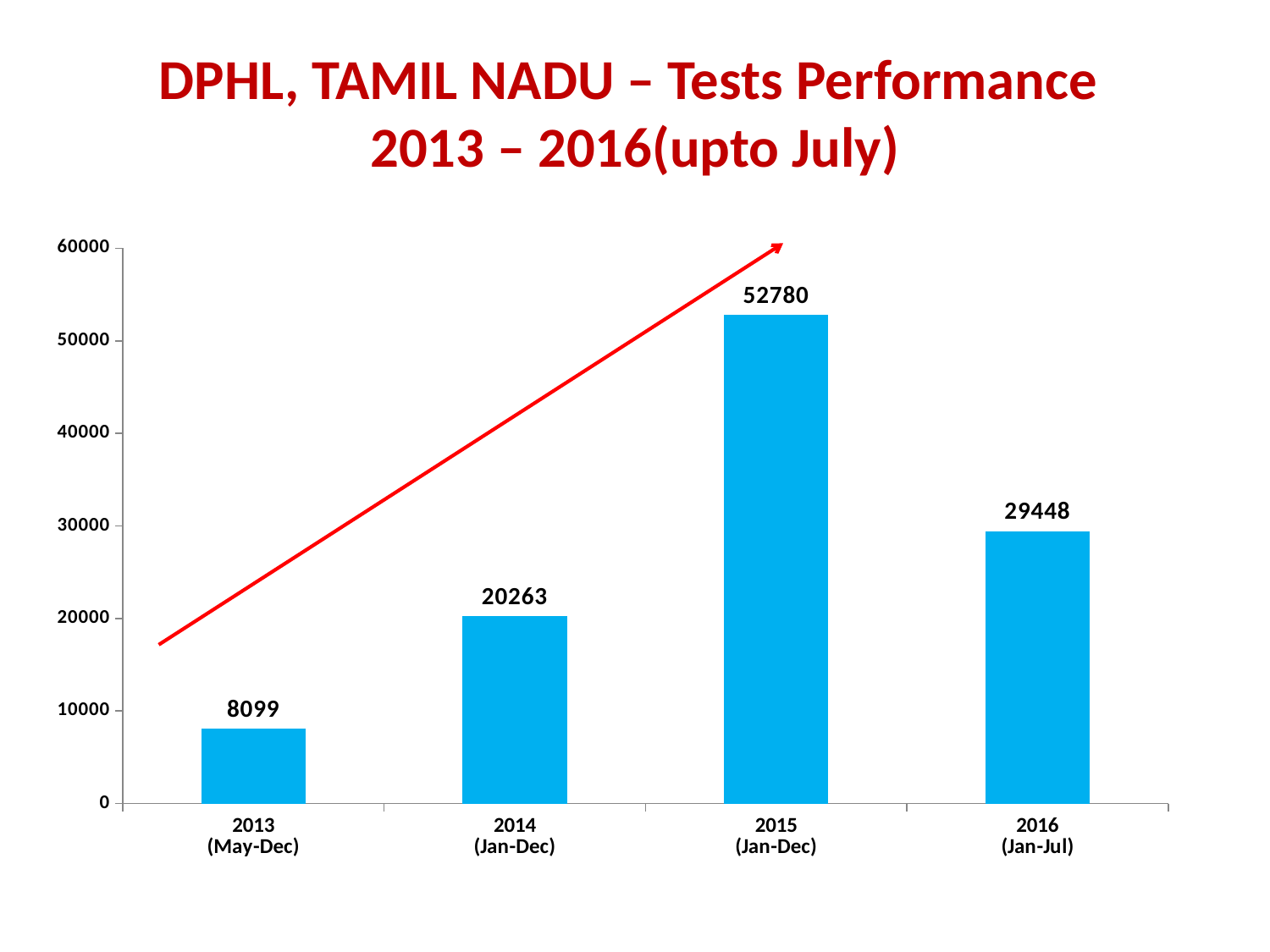
Is the value for 2015 (Jan-Dec) greater or less than 50000? greater What kind of chart is shown on the slide? bar chart How many bars are shown in the chart? 4 What is the value for 2016 (Jan-Jul)? 29448 What is the difference between the values for 2015 (Jan-Dec) and 2014 (Jan-Dec)? 32517 Which year has the highest value? 2015 (Jan-Dec) What is the value for 2015 (Jan-Dec)? 52780 Which year has the lowest value? 2013 (May-Dec) What is the value for 2013 (May-Dec)? 8099 What is the value for 2014 (Jan-Dec)? 20263 Which is larger, the value for 2016 (Jan-Jul) or the value for 2014 (Jan-Dec)? 2016 (Jan-Jul) What is the title of the chart on the slide? DPHL, TAMIL NADU – Tests Performance 2013 – 2016(upto July)